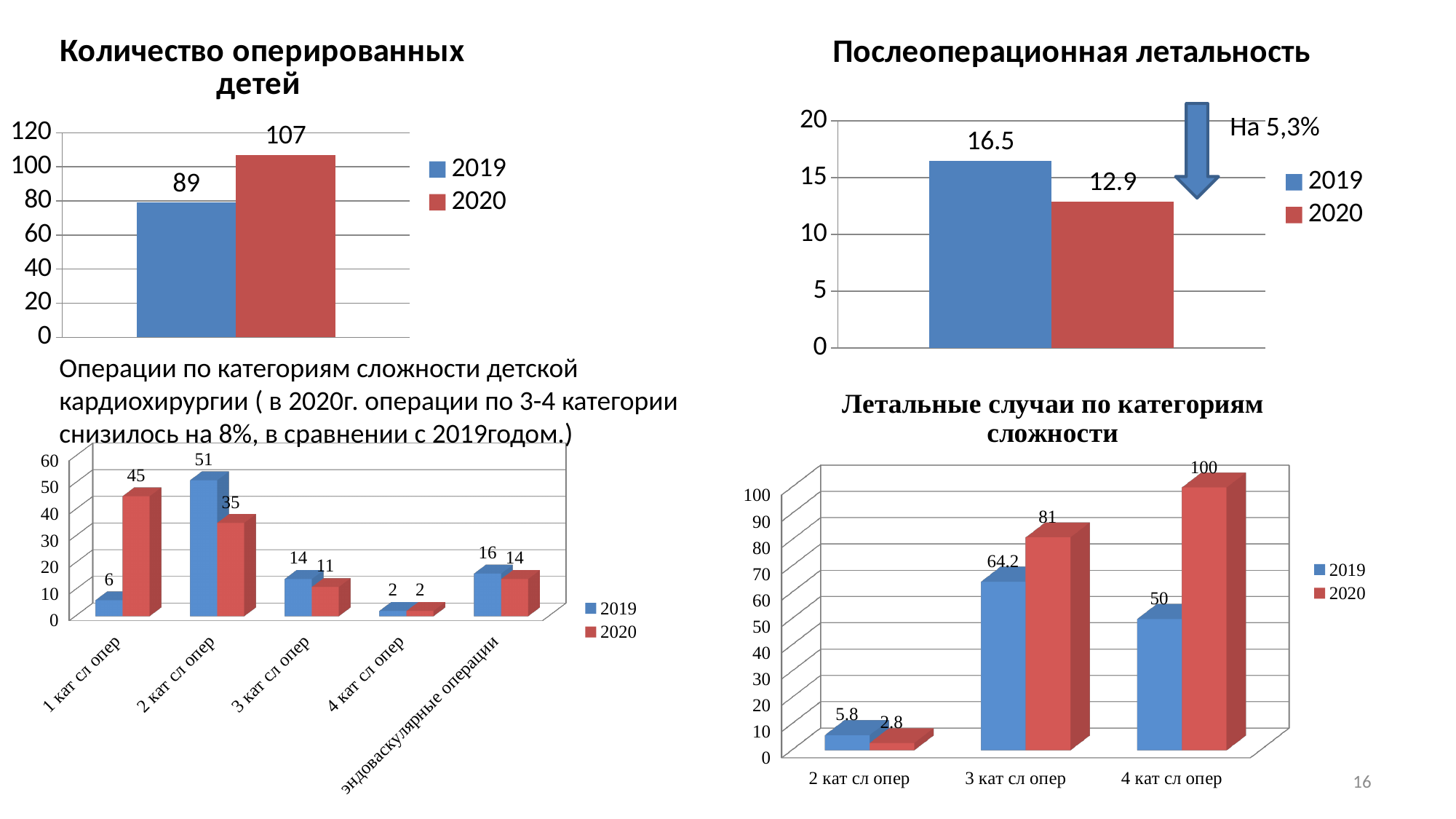
In the bottom-left chart 'Операции по категориям сложности детской кардиохирургии', how many categories are shown on the x axis? 5 In the chart 'Летальные случаи по категориям сложности', which category has the highest 2020 value? 4 кат сл опер In the bottom-left chart 'Операции по категориям сложности детской кардиохирургии', what is the 2020 value for '1 кат сл опер'? 45 In the chart 'Послеоперационная летальность', how many series does the legend list? 2 In the chart 'Количество оперированных детей', what is the difference between the 2020 and 2019 values? 18 In the chart 'Послеоперационная летальность', which year has the lower value, 2019 or 2020? 2020 In the bottom-left chart 'Операции по категориям сложности детской кардиохирургии', what is the difference between the 2019 and 2020 values for '2 кат сл опер'? 16 In the bottom-left chart 'Операции по категориям сложности детской кардиохирургии', which category has the highest 2019 value? 2 кат сл опер In the chart 'Количество оперированных детей', what is the value for 2020? 107 What kind of chart is 'Летальные случаи по категориям сложности'? bar chart In the chart 'Летальные случаи по категориям сложности', what is the 2019 value for '3 кат сл опер'? 64.2 In the chart 'Послеоперационная летальность', what is the value for 2019? 16.5